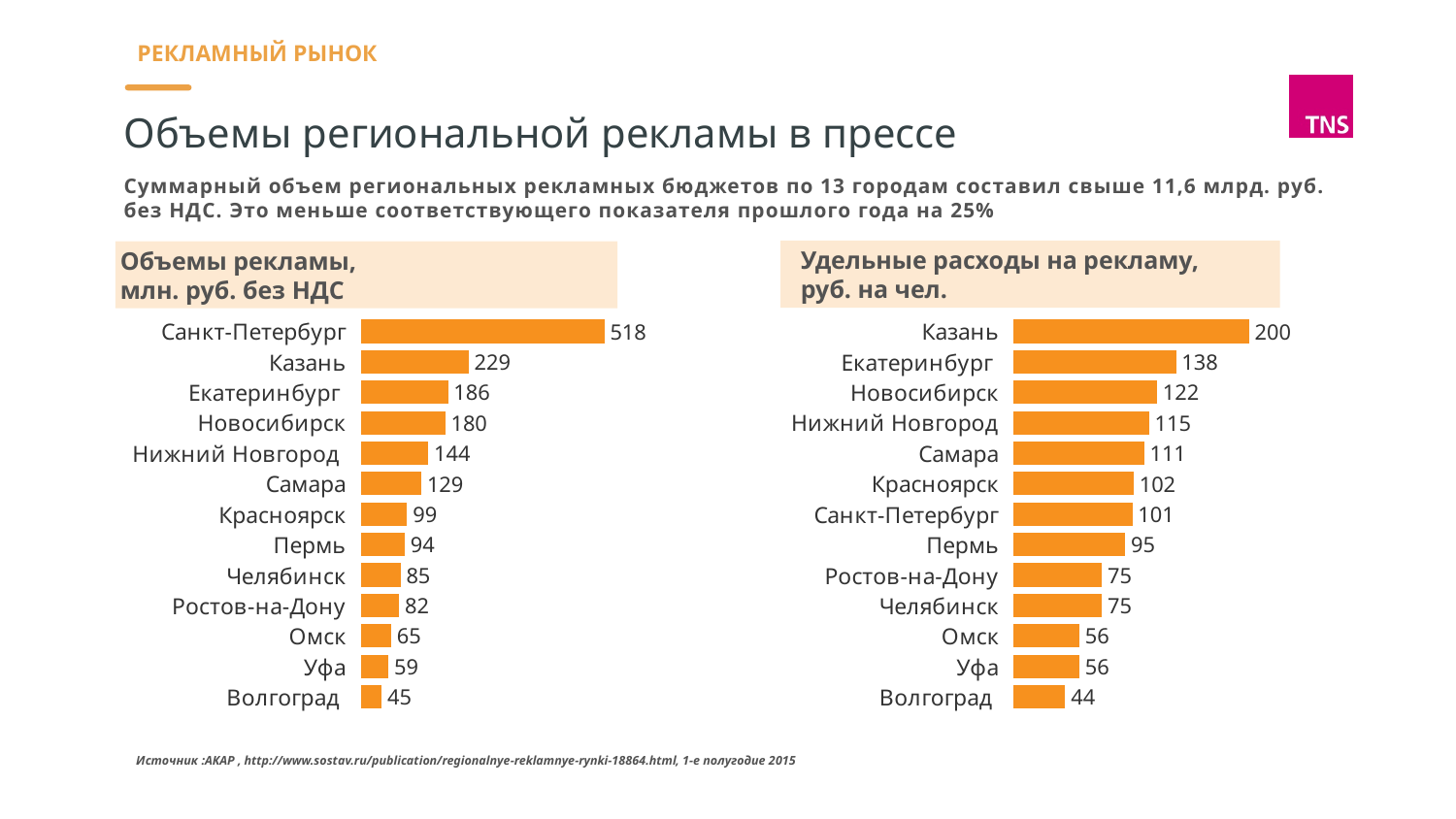
How many cities are shown in the left chart 'Объемы рекламы, млн. руб. без НДС'? 13 In the right chart 'Удельные расходы на рекламу, руб. на чел.', which is larger: Самара or Пермь? Самара What colour are the bars in the left chart 'Объемы рекламы, млн. руб. без НДС'? Orange In the right chart 'Удельные расходы на рекламу, руб. на чел.', what is the value for Казань? 200 In the left chart 'Объемы рекламы, млн. руб. без НДС', which city has the lowest value? Волгоград In the left chart 'Объемы рекламы, млн. руб. без НДС', what is the difference between Санкт-Петербург and Казань? 289 In the right chart 'Удельные расходы на рекламу, руб. на чел.', what is the difference between Екатеринбург and Новосибирск? 16 In the left chart 'Объемы рекламы, млн. руб. без НДС', what is the value for Санкт-Петербург? 518 What type of chart is the right chart 'Удельные расходы на рекламу, руб. на чел.'? Bar chart In the right chart 'Удельные расходы на рекламу, руб. на чел.', which city has the highest value? Казань In the right chart 'Удельные расходы на рекламу, руб. на чел.', what is the value for Санкт-Петербург? 101 In the left chart 'Объемы рекламы, млн. руб. без НДС', which is larger: Новосибирск or Нижний Новгород? Новосибирск